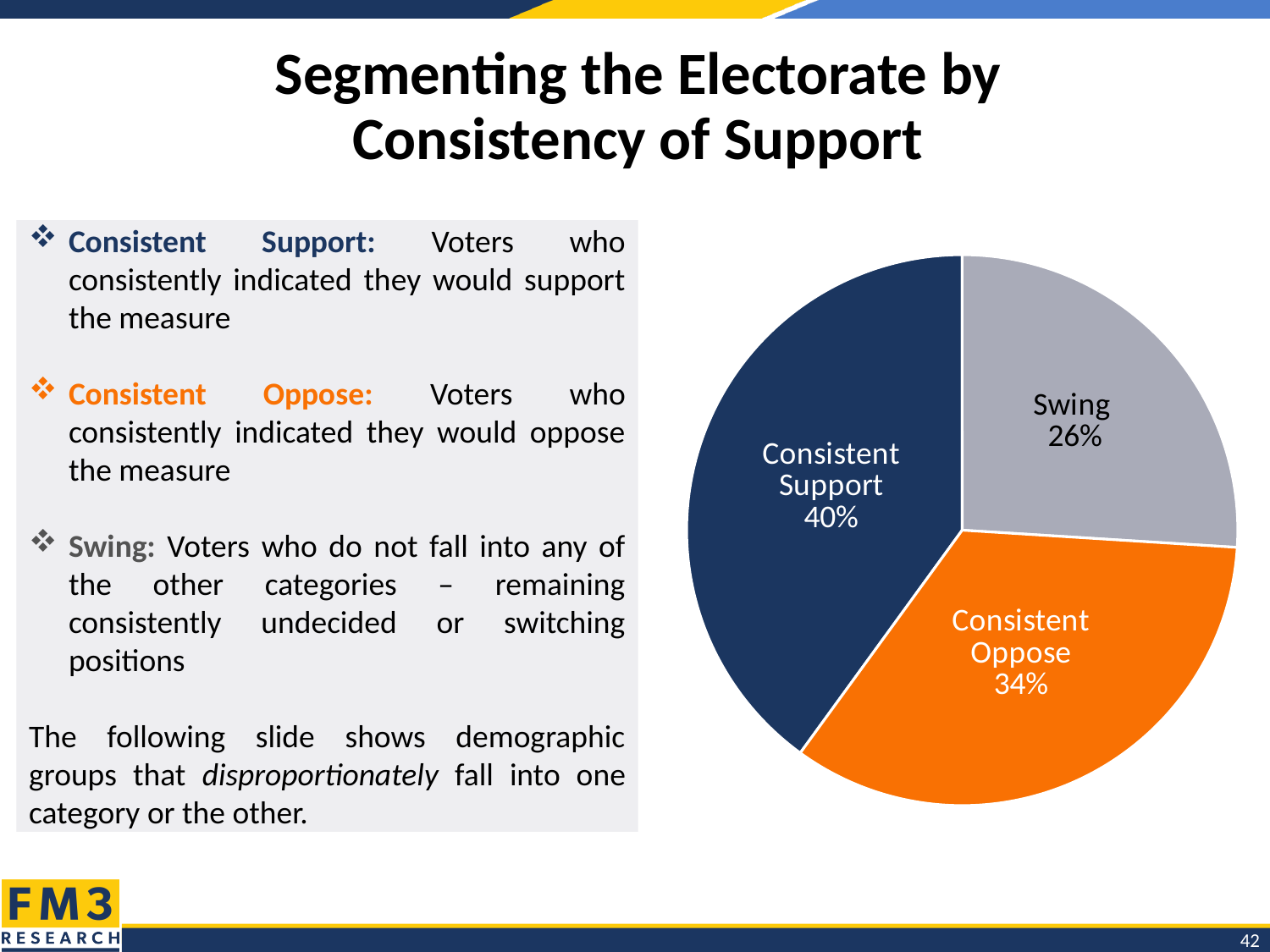
What share of the electorate is labelled Consistent Oppose in the pie chart? 34% How many segments does the pie chart have? 3 What is the difference in percentage points between Consistent Support and Consistent Oppose? 6 Which is larger, the Consistent Oppose share or the Swing share? Consistent Oppose Which segment of the pie chart is the largest? Consistent Support What colour is the Consistent Oppose segment of the pie chart? Orange What type of chart is shown on the slide? Pie chart What share of the electorate is labelled Swing in the pie chart? 26% What share of the electorate is labelled Consistent Support in the pie chart? 40% Which segment of the pie chart is the smallest? Swing What is the difference in percentage points between Consistent Oppose and Swing? 8 What colour is the Swing segment of the pie chart? Grey